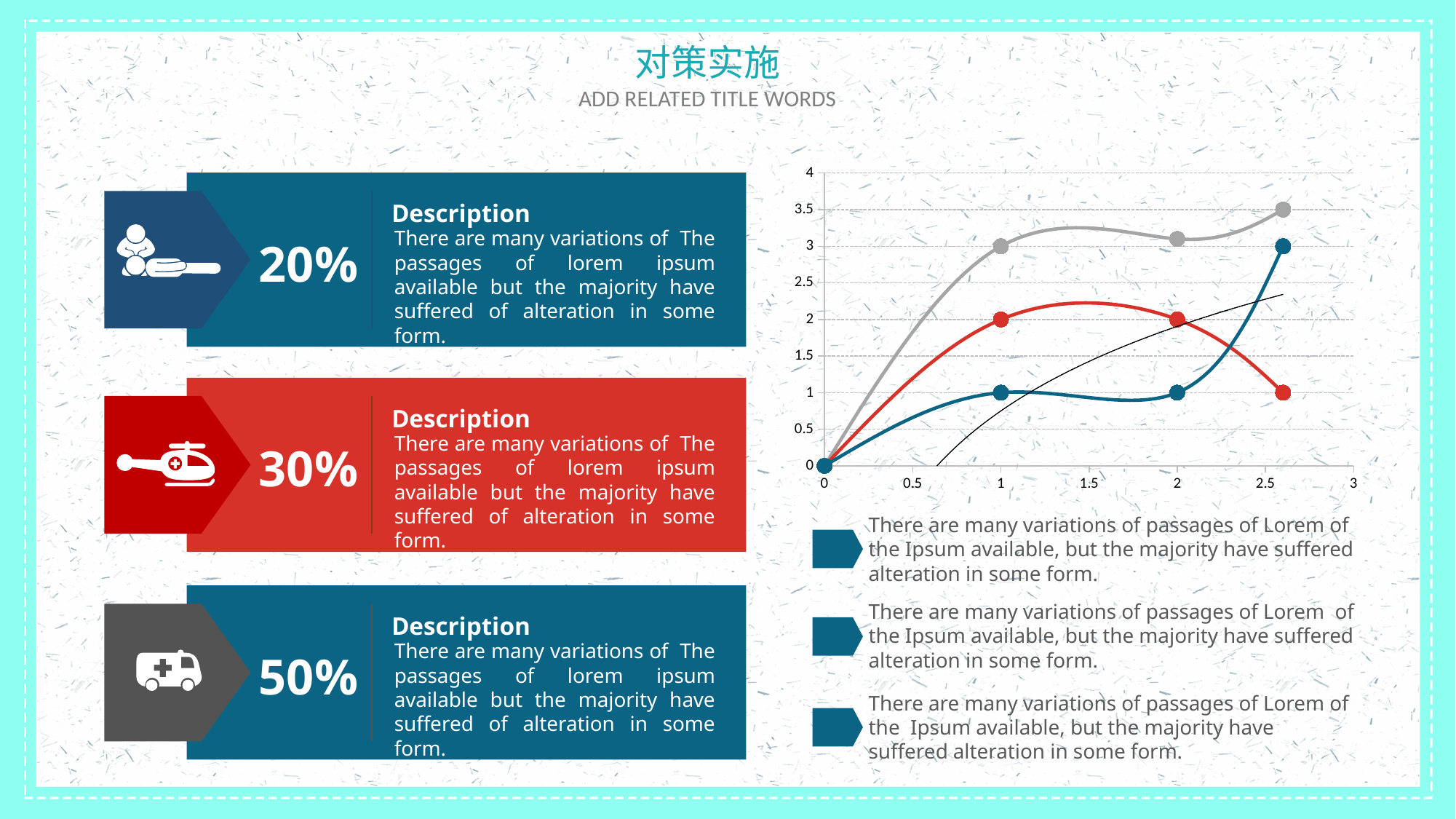
What is the value of the gray series at x = 1? 3 Which series has the lowest value at x = 2? the blue series How many marked data points does the red series have? 4 What is the value of the blue series at x = 2? 1 Does the red series rise or fall between x = 2 and its last data point? fall What is the difference between the gray series and the blue series at x = 1? 2 What is the maximum value shown on the chart's vertical axis? 4 What kind of chart is shown on the right side of the slide? line chart How many coloured data series (lines with markers) are plotted in the chart? 3 What is the value of the red series at x = 1? 2 At the last data point, is the blue series or the red series higher? the blue series Which series has the highest value at x = 1? the gray series